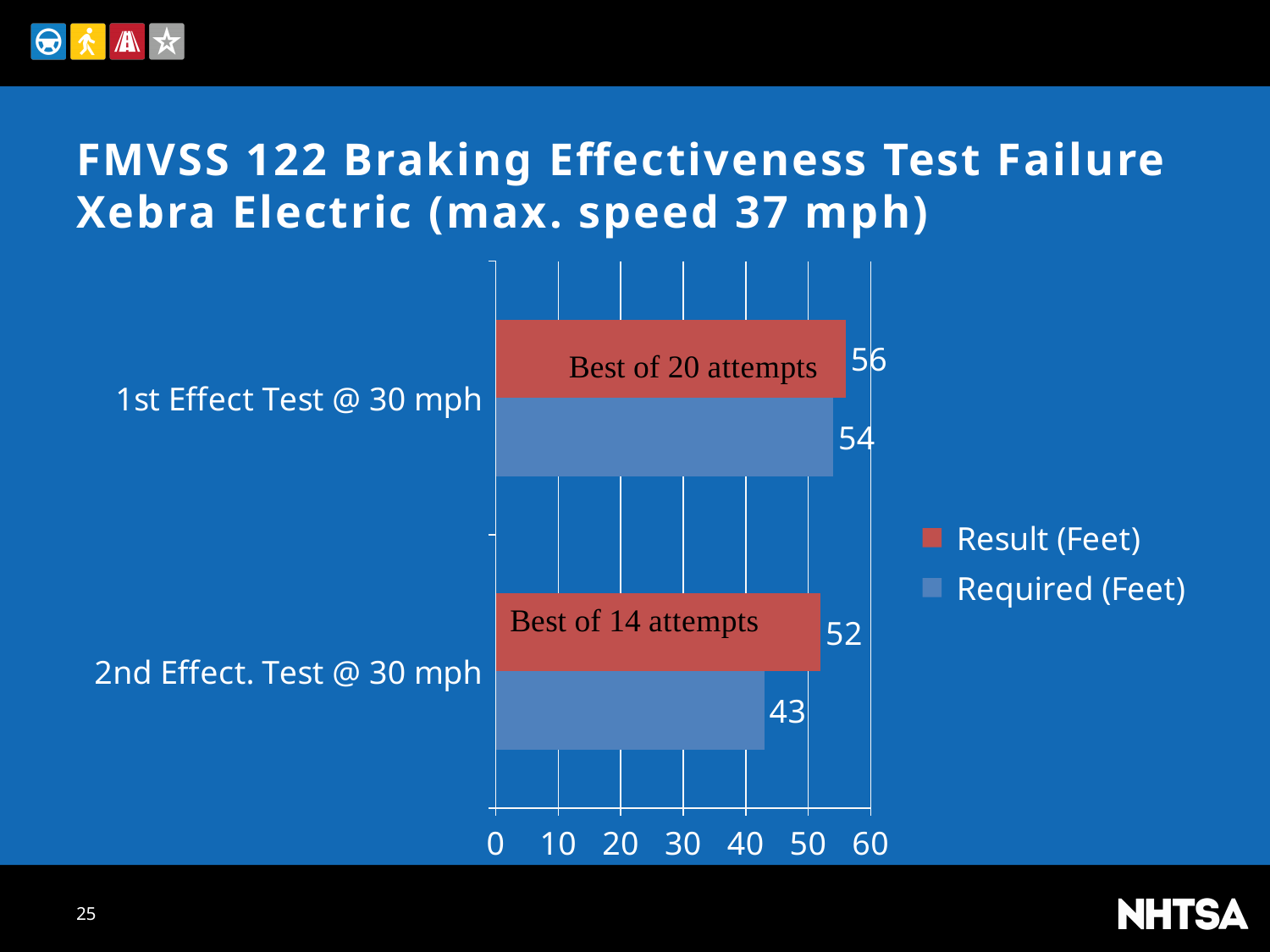
Which is larger for the 1st Effect Test @ 30 mph, the Result (Feet) or the Required (Feet) value? Result (Feet) What is the difference between the Result (Feet) and Required (Feet) values for the 2nd Effect. Test @ 30 mph? 9 What is the Result (Feet) value for the 1st Effect Test @ 30 mph? 56 What is the Required (Feet) value for the 2nd Effect. Test @ 30 mph? 43 What is the Result (Feet) value for the 2nd Effect. Test @ 30 mph? 52 What is the Required (Feet) value for the 1st Effect Test @ 30 mph? 54 Which test has the highest Result (Feet) value? 1st Effect Test @ 30 mph What text label is printed on the Result (Feet) bar for the 2nd Effect. Test @ 30 mph? Best of 14 attempts How many series does the legend list? 2 Which test has the lowest Required (Feet) value? 2nd Effect. Test @ 30 mph How many test categories are shown on the chart? 2 What kind of chart is shown on the slide? Bar chart